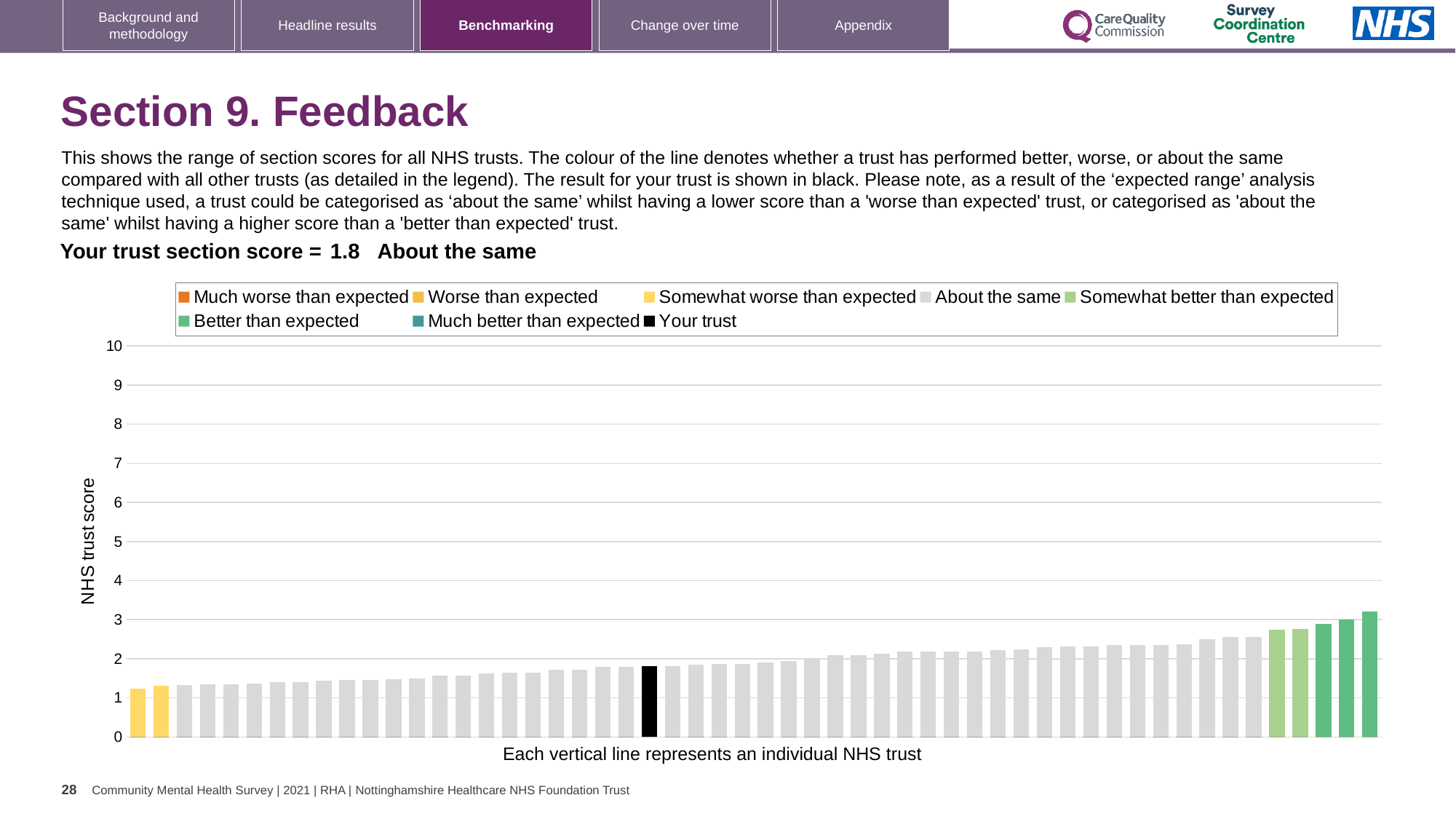
Which performance category is your trust placed in for this section? About the same What kind of chart is shown on the slide? bar chart Is the value of the lowest bar greater or less than 1? greater What is the section score for your trust? 1.8 Is the value of the highest bar greater or less than 4? less Is the value of the highest bar greater or less than 3? greater Do the bar values rise or fall from left to right along the x axis? rise What colour is the bar representing your trust? black What is the label on the vertical axis? NHS trust score How many bars are shaded yellow? 2 How many entries does the legend list? 8